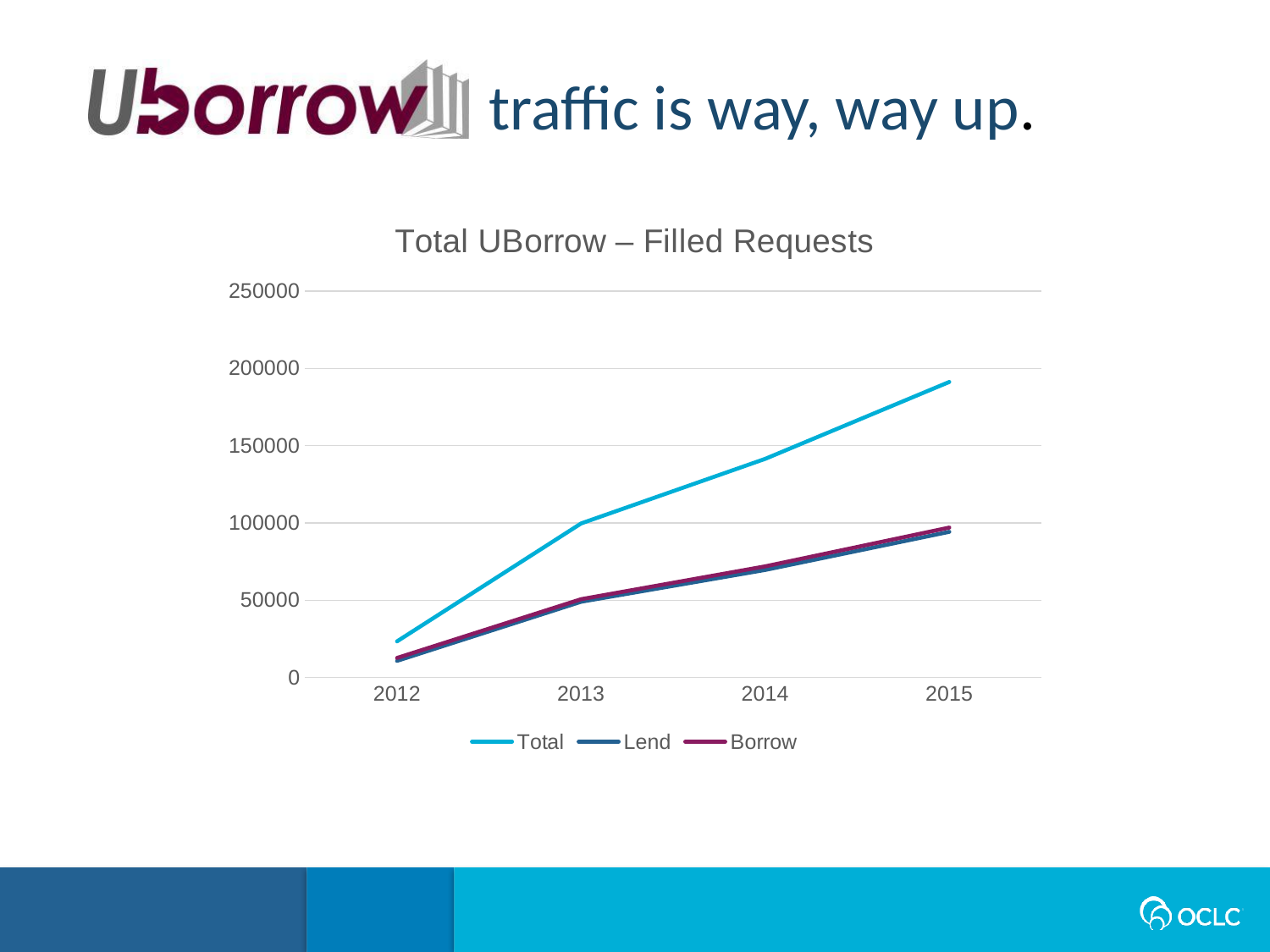
In which year is the Total series lowest? 2012 What is the title of the chart? Total UBorrow – Filled Requests How many series does the legend list? 3 Is the value for Lend in 2014 greater or less than 50000? greater Is the value for Total in 2015 greater or less than 150000? greater What kind of chart is shown on the slide? line chart Is the value for Total in 2012 greater or less than 50000? less How many years are shown on the x axis? 4 Does the Total series rise or fall from 2012 to 2015? rise In which year is the Total series highest? 2015 In 2015, which is larger, Total or Lend? Total